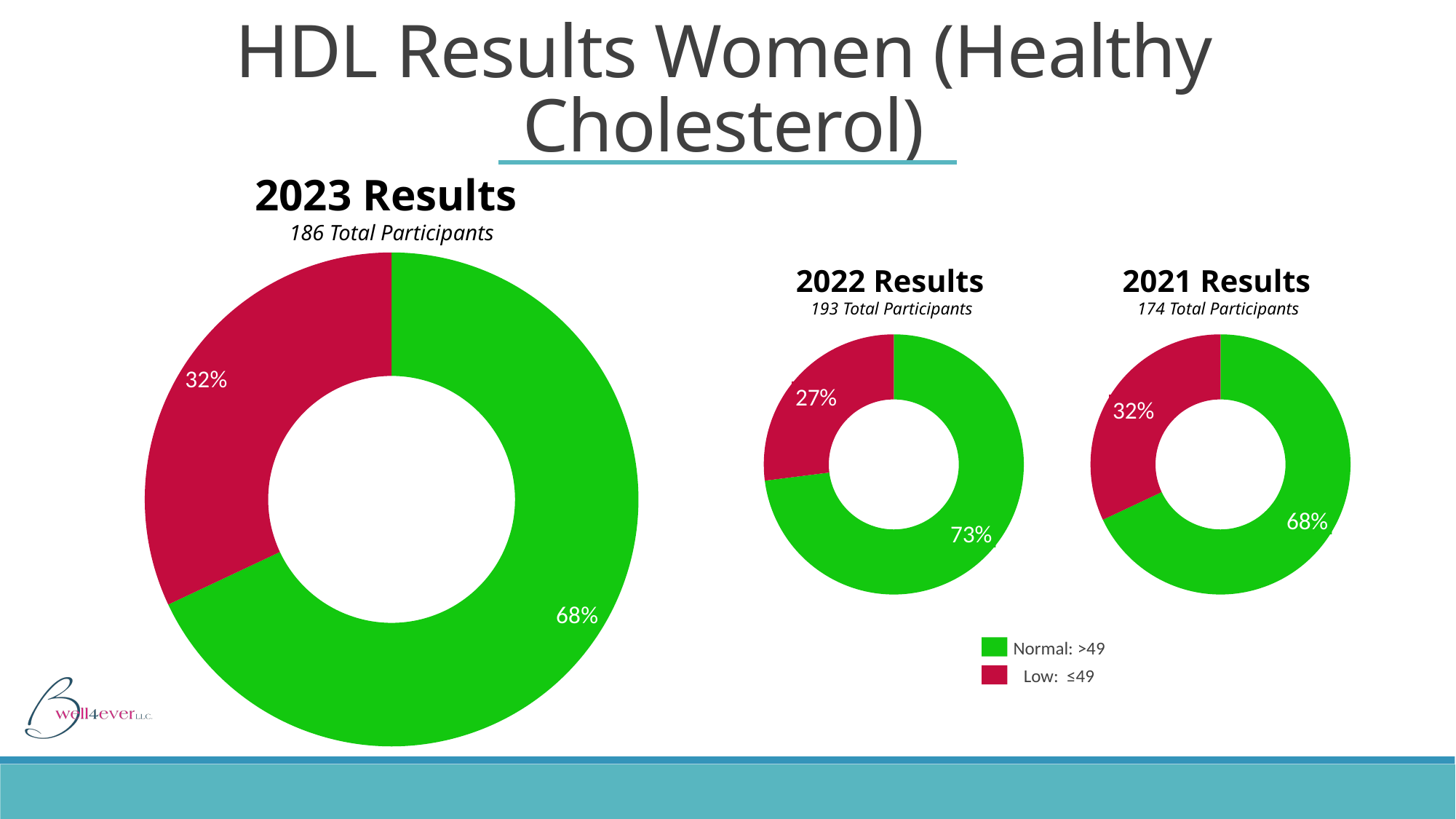
What HDL threshold does the legend give for the Normal category? >49 In the 2023 Results chart, what is the difference between the Normal and Low percentages? 36% How many total participants are reported for the 2022 Results chart? 193 How many categories does the legend list? 2 In the 2023 Results chart, what percentage of participants had Low HDL? 32% In the 2021 Results chart, what percentage of participants had Low HDL? 32% In the 2021 Results chart, which category has the larger share? Normal In the 2023 Results chart, what percentage of participants had Normal HDL? 68% In the 2022 Results chart, what percentage of participants had Normal HDL? 73% Is the Normal share larger in the 2022 Results chart or the 2021 Results chart? 2022 Results What kind of chart is used for the 2023 Results? Doughnut (pie) chart In the 2022 Results chart, which category has the smaller share? Low